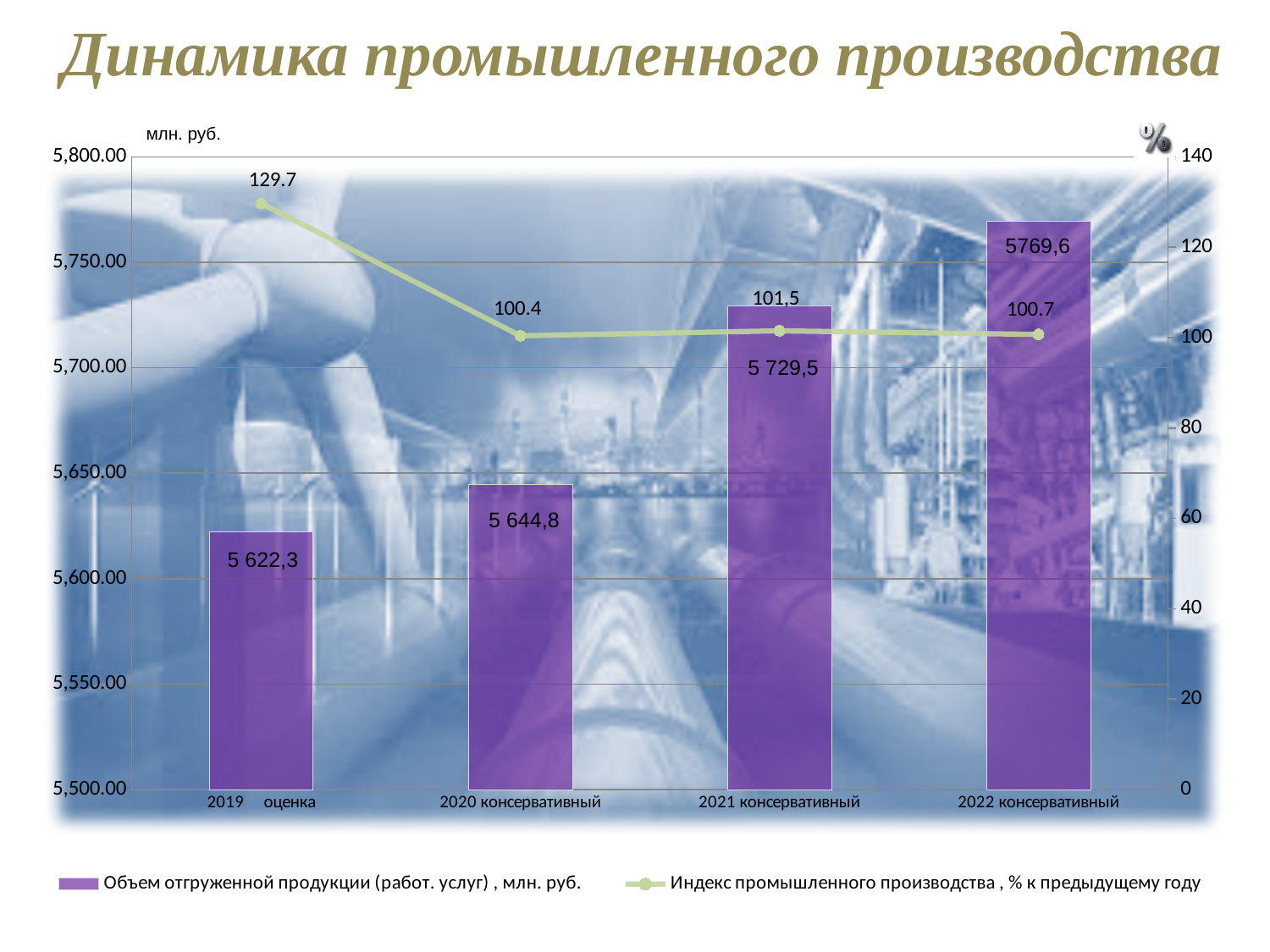
Do the bar values rise or fall from 2019 to 2022? rise What is the value of the Индекс промышленного производства line for 2019 оценка? 129.7 How many categories are shown on the x axis? 4 What is the value of the bar for 2022 консервативный? 5769,6 Which category has the highest bar for Объем отгруженной продукции? 2022 консервативный What is the value of the bar for 2019 оценка? 5 622,3 What is the title of the chart on the slide? Динамика промышленного производства Which category has the lowest value of the Индекс промышленного производства line? 2020 консервативный What is the value of the Индекс промышленного производства line for 2021 консервативный? 101,5 What is the difference between the bar values for 2021 консервативный and 2020 консервативный? 84,7 How many series does the legend list? 2 Which is larger: the index value for 2021 консервативный or for 2022 консервативный? 2021 консервативный